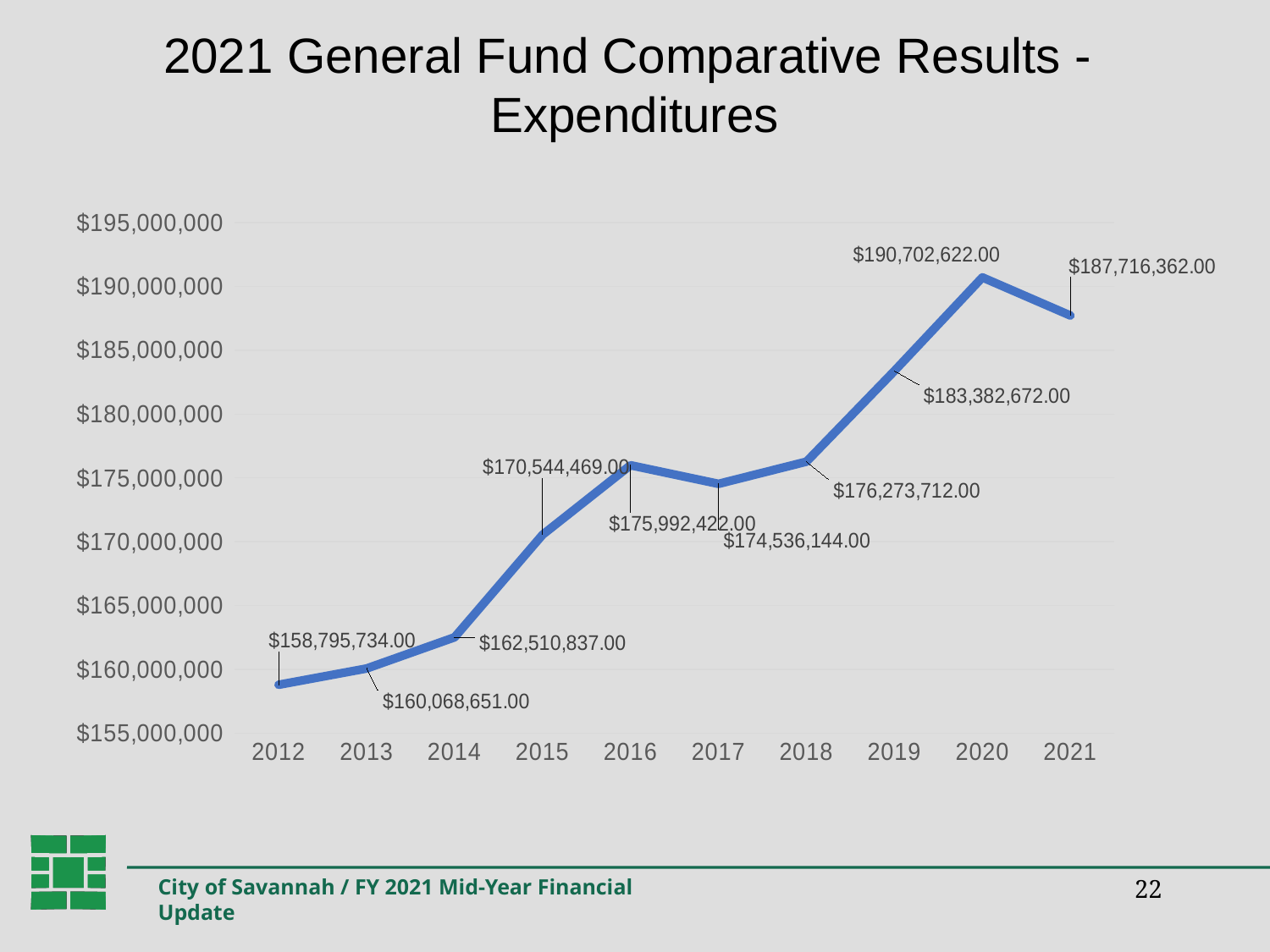
Which is larger, the expenditure value for 2016 or for 2017? 2016 Is the expenditure value for 2019 greater or less than $180,000,000? greater Which year has the lowest expenditure value? 2012 What is the difference between the 2020 and 2021 expenditure values? $2,986,260.00 Which year has the highest expenditure value? 2020 What was the expenditure value for 2017? $174,536,144.00 What was the expenditure value for 2012? $158,795,734.00 What was the expenditure value for 2021? $187,716,362.00 What type of chart is shown on the slide? line chart What was the expenditure value for 2020? $190,702,622.00 Do the expenditure values generally rise or fall from 2012 to 2020? rise How many years are plotted on the x axis? 10